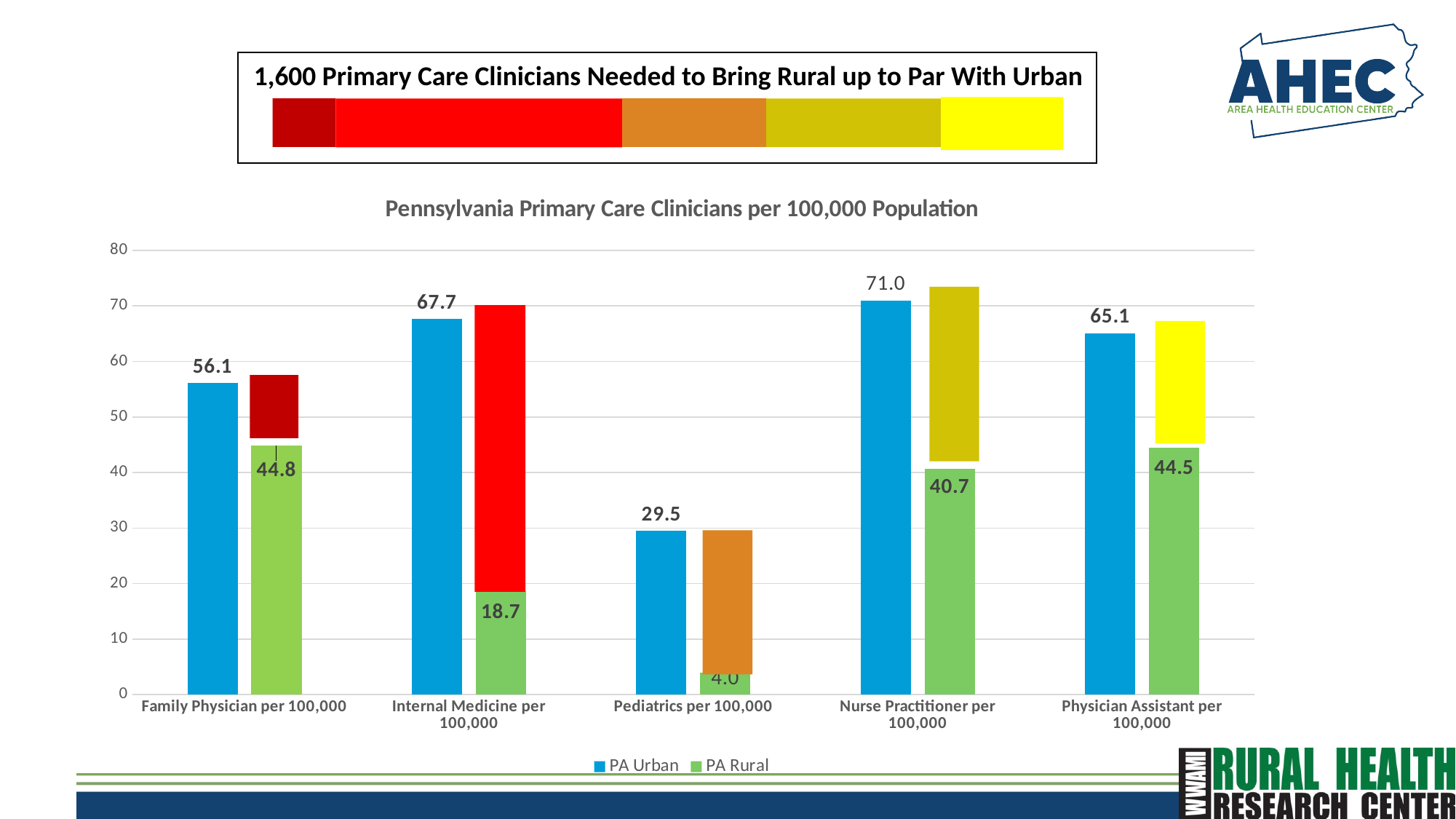
Which is larger: the PA Rural value for Family Physician per 100,000 or the PA Rural value for Nurse Practitioner per 100,000? Family Physician per 100,000 What is the PA Urban value for Nurse Practitioner per 100,000? 71.0 What is the PA Rural value for Pediatrics per 100,000? 4.0 Which category has the lowest PA Rural value? Pediatrics per 100,000 Which category has the highest PA Urban value? Nurse Practitioner per 100,000 How many series does the legend list? 2 What is the PA Urban value for Physician Assistant per 100,000? 65.1 What kind of chart is shown? Bar chart What is the difference between the PA Urban and PA Rural values for Internal Medicine per 100,000? 49.0 What is the PA Rural value for Internal Medicine per 100,000? 18.7 What is the title of the chart? Pennsylvania Primary Care Clinicians per 100,000 Population How many categories are shown on the x axis? 5